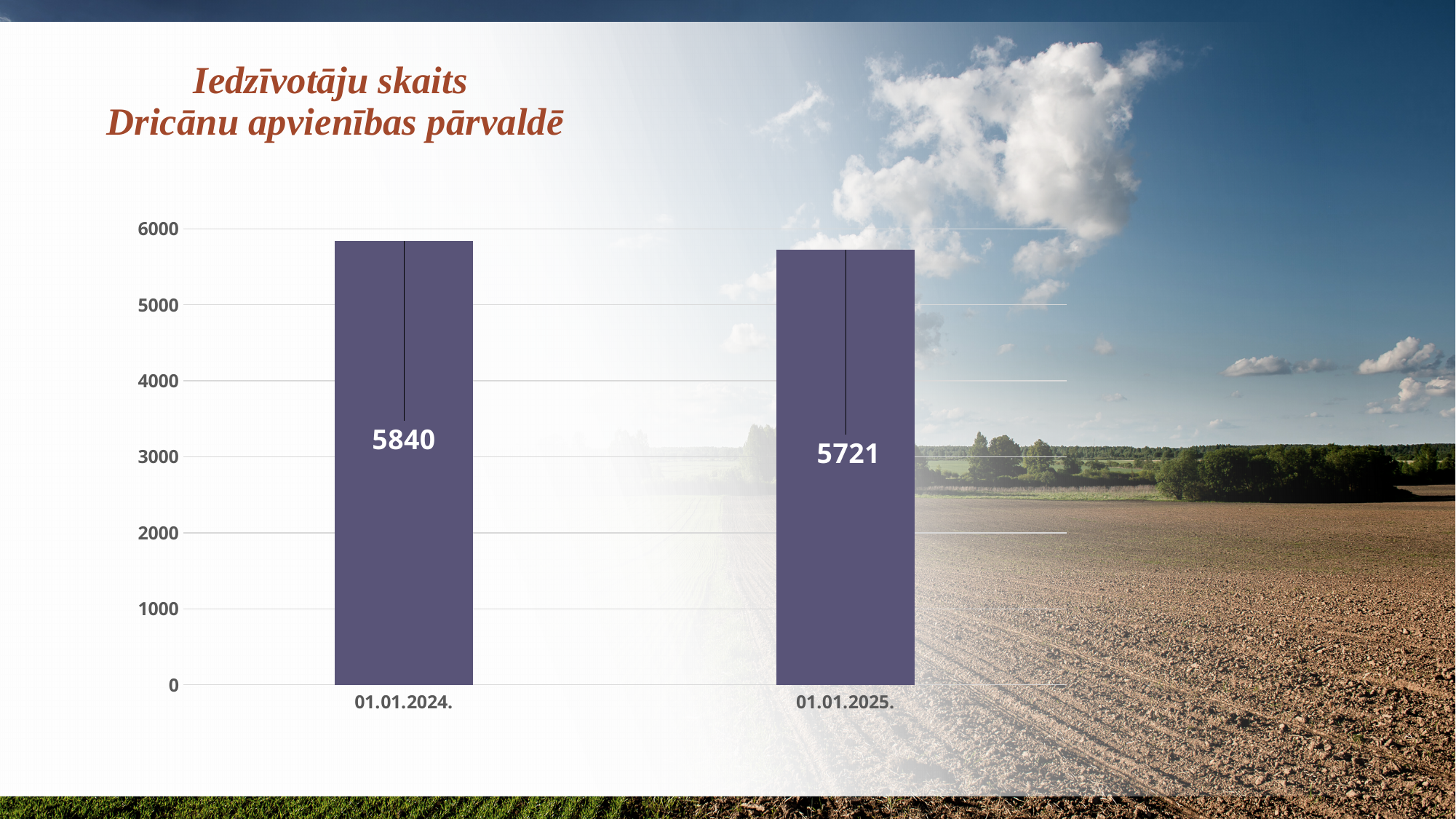
How many categories are shown on the x axis? 2 Which category has the highest value? 01.01.2024. What kind of chart is shown on the slide? bar chart What is the value for 01.01.2024.? 5840 What is the difference between the values for 01.01.2024. and 01.01.2025.? 119 Is the value for 01.01.2025. greater or less than 6000? less What is the value for 01.01.2025.? 5721 What is the title of the chart? Iedzīvotāju skaits Dricānu apvienības pārvaldē Is the value for 01.01.2024. greater or less than 5000? greater Do the values rise or fall from 01.01.2024. to 01.01.2025.? fall Which is larger, the value for 01.01.2024. or the value for 01.01.2025.? 01.01.2024. Which category has the lowest value? 01.01.2025.